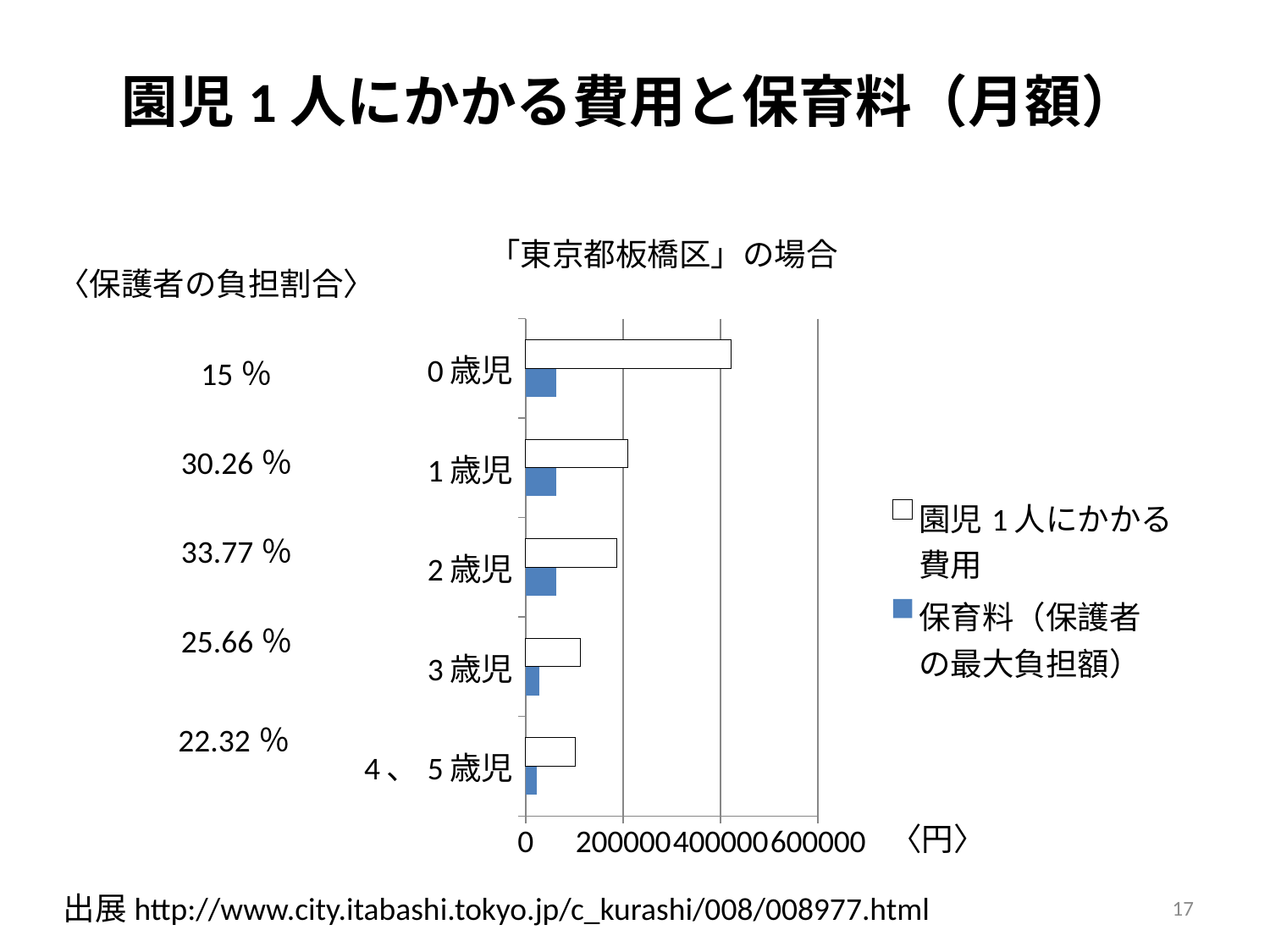
What kind of chart is shown on the slide? bar chart How many age categories are plotted on the chart? 5 Which age category has the highest 園児1人にかかる費用? 0歳児 Which is larger, the 園児1人にかかる費用 for 0歳児 or for 1歳児? 0歳児 Does the 園児1人にかかる費用 rise or fall going from 0歳児 down to 4、5歳児? fall Is the 保育料（保護者の最大負担額） for 0歳児 greater or less than 200000? less What unit is shown next to the horizontal axis of the chart? 〈円〉 Is the 園児1人にかかる費用 for 3歳児 greater or less than 200000? less What is the title of the chart? 「東京都板橋区」の場合 Which is larger, the 保育料（保護者の最大負担額） for 0歳児 or for 3歳児? 0歳児 How many series does the chart legend list? 2 Is the 園児1人にかかる費用 for 0歳児 greater or less than 200000? greater